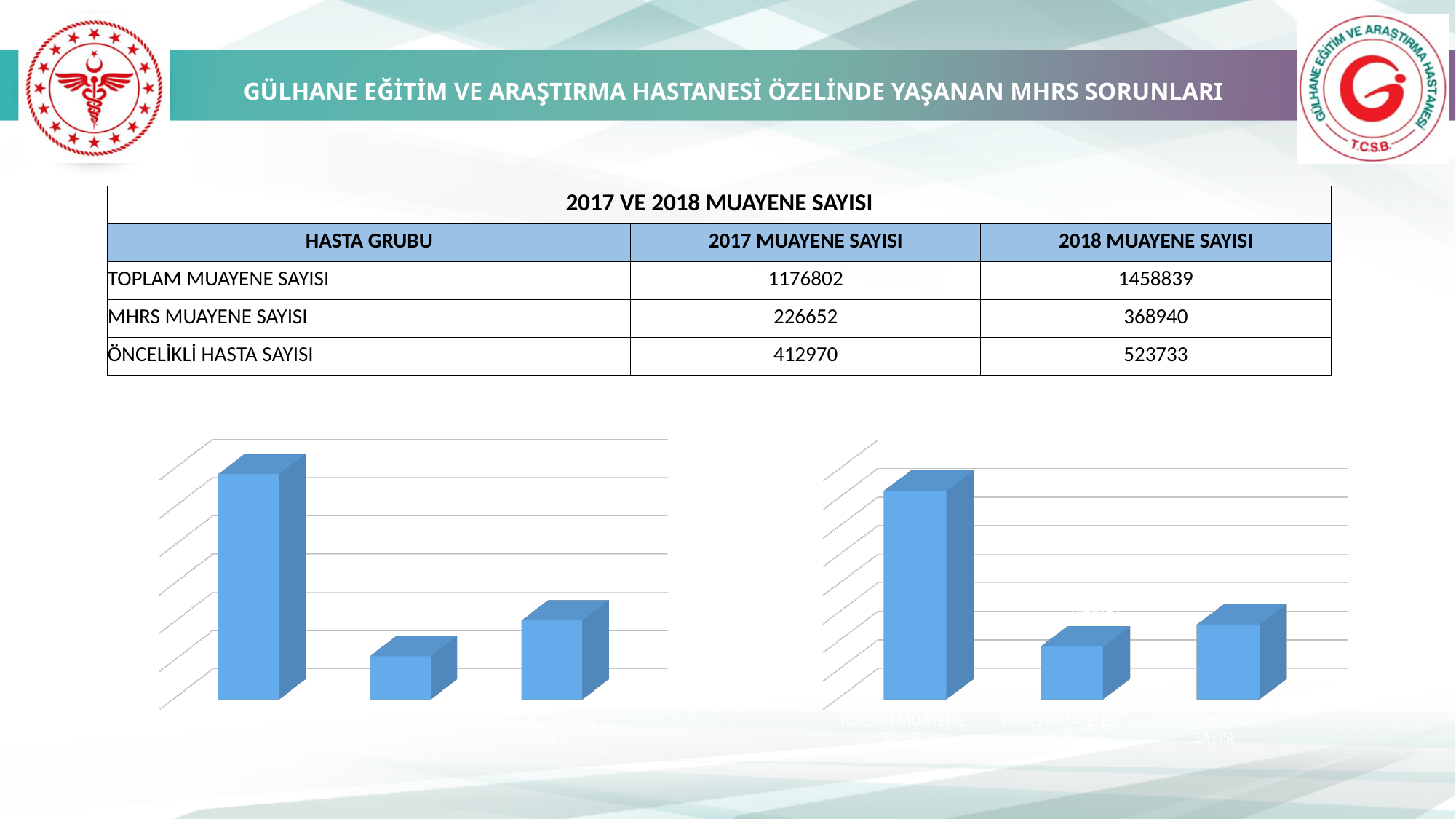
What kind of chart is the chart on the left side of the slide? bar chart In the chart on the right side of the slide, which category has the tallest bar? TOPLAM MUAYENE SAYISI In the chart on the left side of the slide, is the first bar taller or shorter than the second bar? taller How many bars does the chart on the right side of the slide have? 3 In the chart on the right side of the slide, which bar is taller: MHRS MUAYENE SAYISI or ÖNCELİKLİ HASTA SAYISI? ÖNCELİKLİ HASTA SAYISI What colour are the bars in both charts on the slide? blue In the chart on the left side of the slide, which bar is the shortest: the first, second or third? the second How many bars does the chart on the left side of the slide have? 3 In the chart on the right side of the slide, which category has the shortest bar? MHRS MUAYENE SAYISI What kind of chart is the chart on the right side of the slide? bar chart What is the title of the table above the charts? 2017 VE 2018 MUAYENE SAYISI